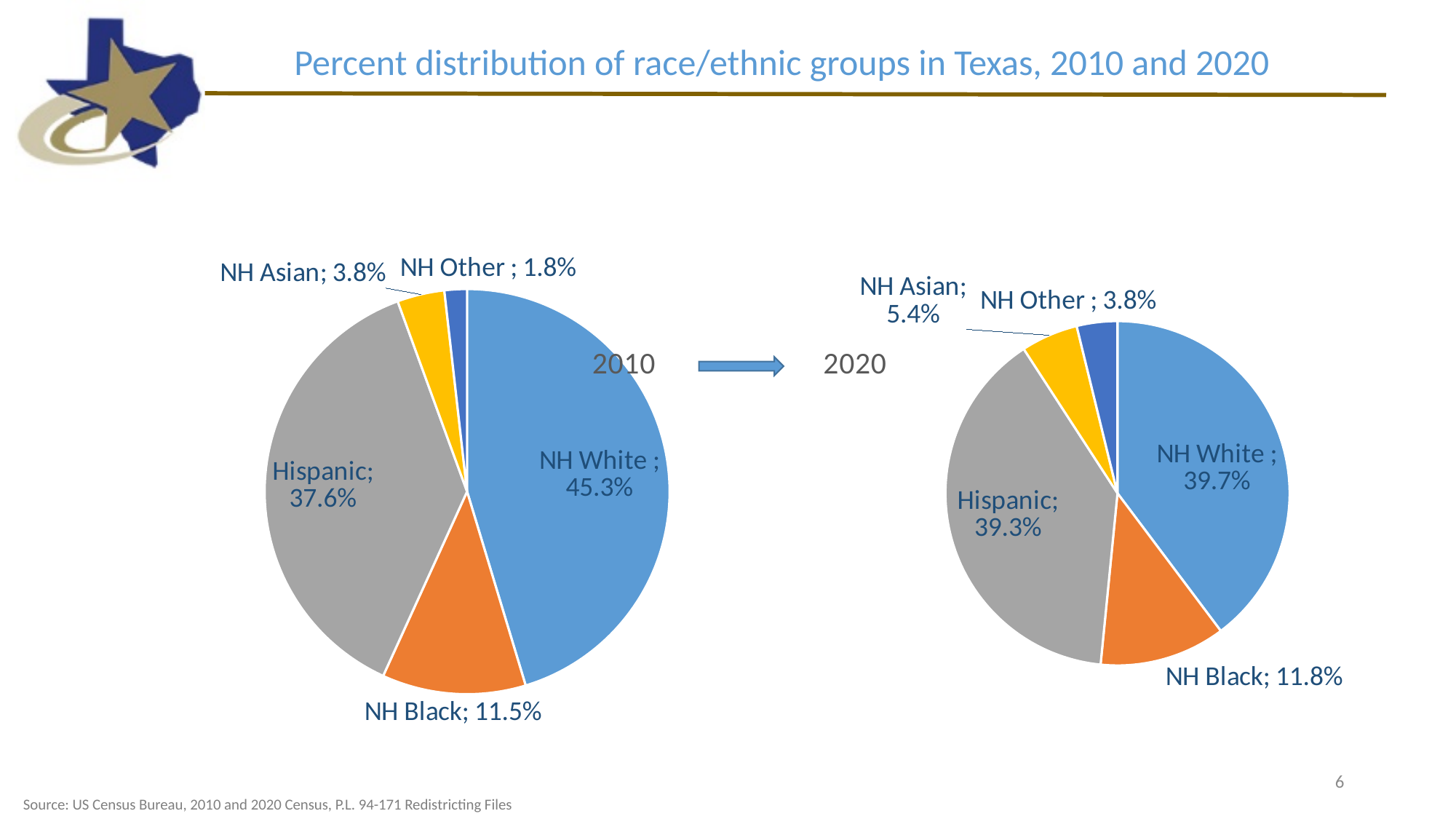
What type of chart is used on this slide? Pie chart How many groups are shown in the 2010 pie chart? 5 In the 2020 pie chart, what is the share for Hispanic? 39.3% In the 2010 pie chart, what is the share for NH White? 45.3% In the 2010 pie chart, which group has the smallest share? NH Other What colour is the Hispanic slice in both pie charts? Gray What is the difference between the NH Other share in 2020 and in 2010? 2.0% In the 2020 pie chart, which group has the largest share? NH White In the 2020 pie chart, which is larger, the NH Asian share or the NH Other share? NH Asian In the 2010 pie chart, what is the share for NH Black? 11.5% In the 2010 pie chart, what is the difference between the NH White share and the Hispanic share? 7.7% In the 2020 pie chart, what is the share for NH Asian? 5.4%